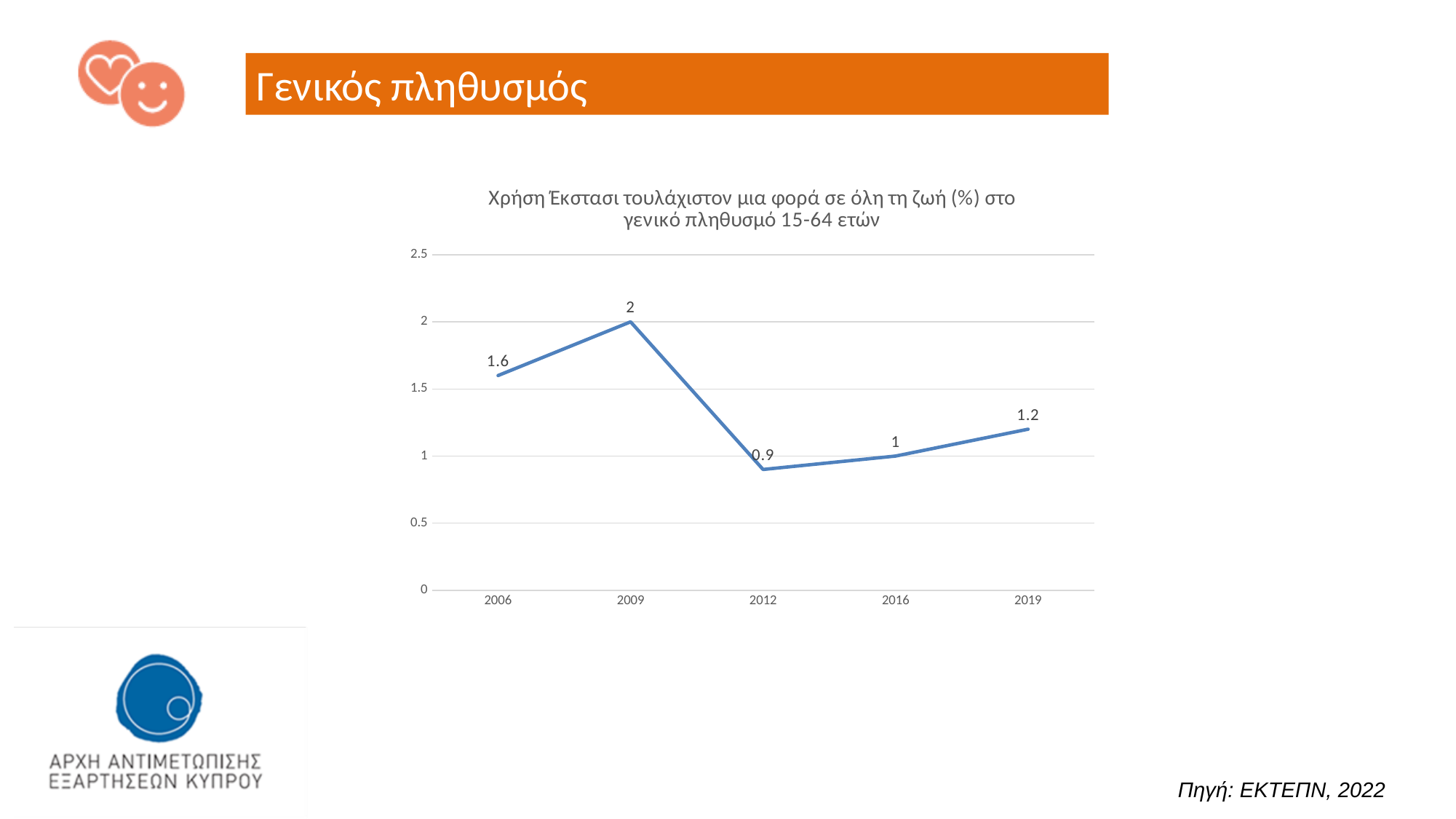
Which year has the highest value? 2009 What is the value for 2012? 0.9 What is the value for 2006? 1.6 Which is larger, the value for 2006 or the value for 2019? 2006 Is the value for 2016 greater or less than 1.5? less Do the values rise or fall from 2012 to 2019? rise What kind of chart is shown? line chart What is the value for 2019? 1.2 How many years are plotted on the x axis? 5 Which year has the lowest value? 2012 What is the value for 2009? 2 What is the difference between the values for 2009 and 2012? 1.1